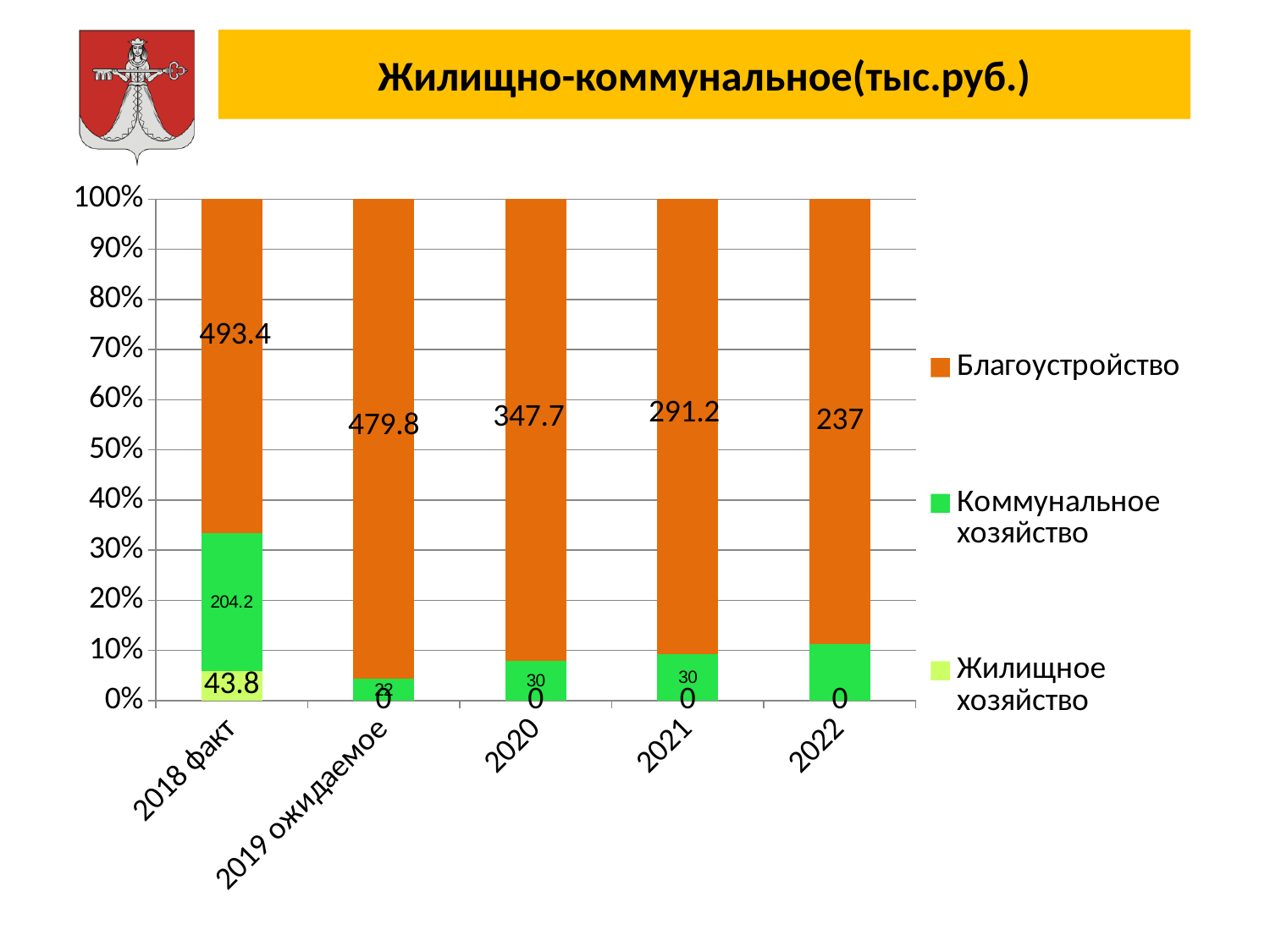
In which category is the value for Благоустройство the lowest? 2022 What is the value for Коммунальное хозяйство in 2018 факт? 204.2 Does the value for Благоустройство rise or fall from 2018 факт to 2022? fall What is the difference between the Благоустройство values for 2018 факт and 2022? 256.4 In which category is the value for Благоустройство the highest? 2018 факт How many series does the legend list? 3 What is the value for Жилищное хозяйство in 2018 факт? 43.8 What is the value for Благоустройство in 2018 факт? 493.4 How many categories are shown on the x axis? 5 What is the value for Благоустройство in 2022? 237 Which is larger, the Благоустройство value for 2020 or for 2021? 2020 What is the value for Жилищное хозяйство in 2021? 0